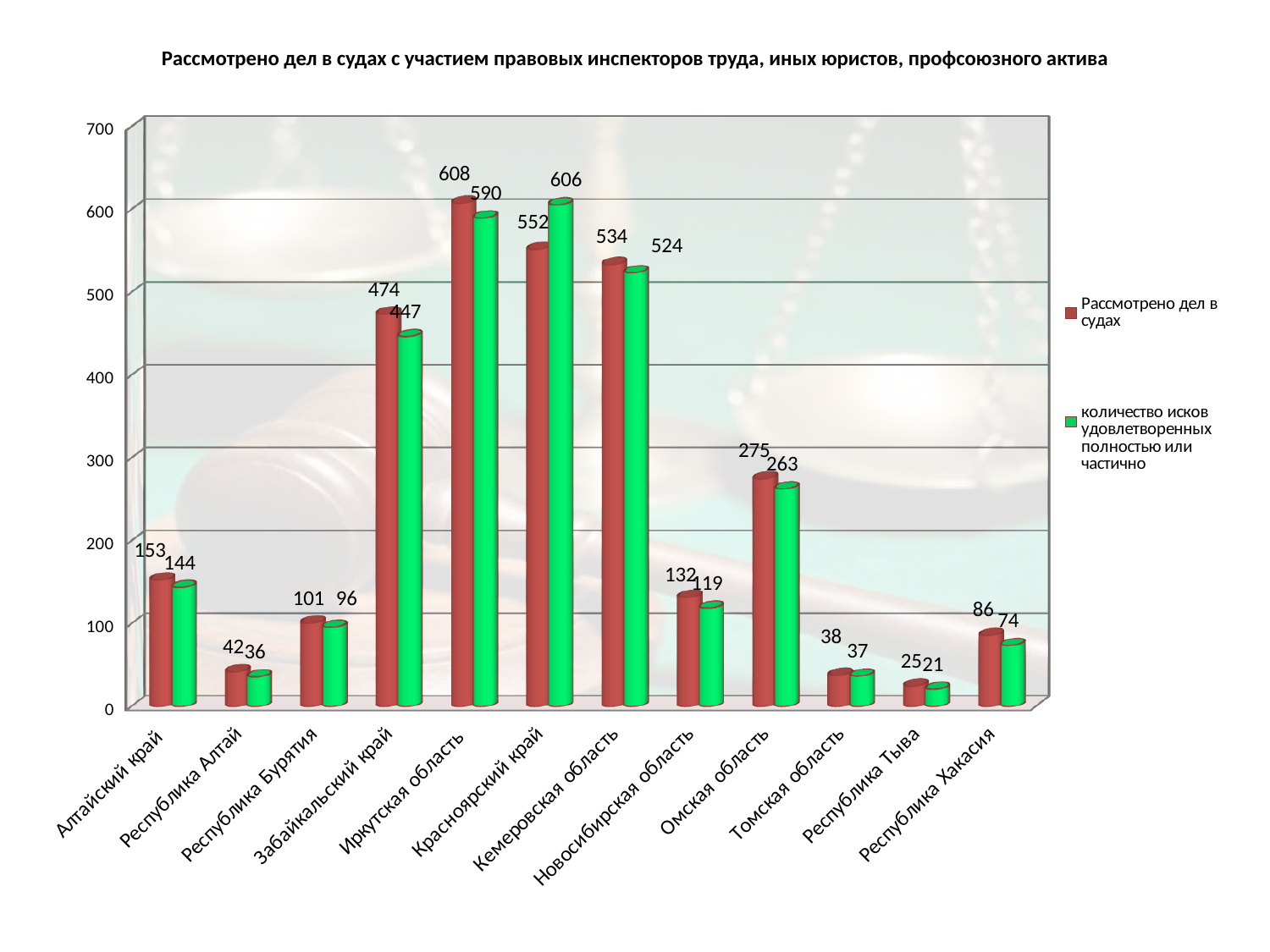
Which region has the lowest value for "количество исков удовлетворенных полностью или частично"? Республика Тыва What kind of chart is shown on the slide? Bar chart What colour are the bars for the series "Рассмотрено дел в судах"? Red For Красноярский край, which is larger: "Рассмотрено дел в судах" or "количество исков удовлетворенных полностью или частично"? количество исков удовлетворенных полностью или частично What is the value of "количество исков удовлетворенных полностью или частично" for Омская область? 263 What is the difference between "Рассмотрено дел в судах" and "количество исков удовлетворенных полностью или частично" for Забайкальский край? 27 Which region has the highest value for "Рассмотрено дел в судах"? Иркутская область Is the value of "Рассмотрено дел в судах" for Кемеровская область greater or less than 500? greater What is the value of "Рассмотрено дел в судах" for Республика Хакасия? 86 How many series does the legend list? 2 What is the value of "Рассмотрено дел в судах" for Иркутская область? 608 How many regions are shown on the x axis? 12